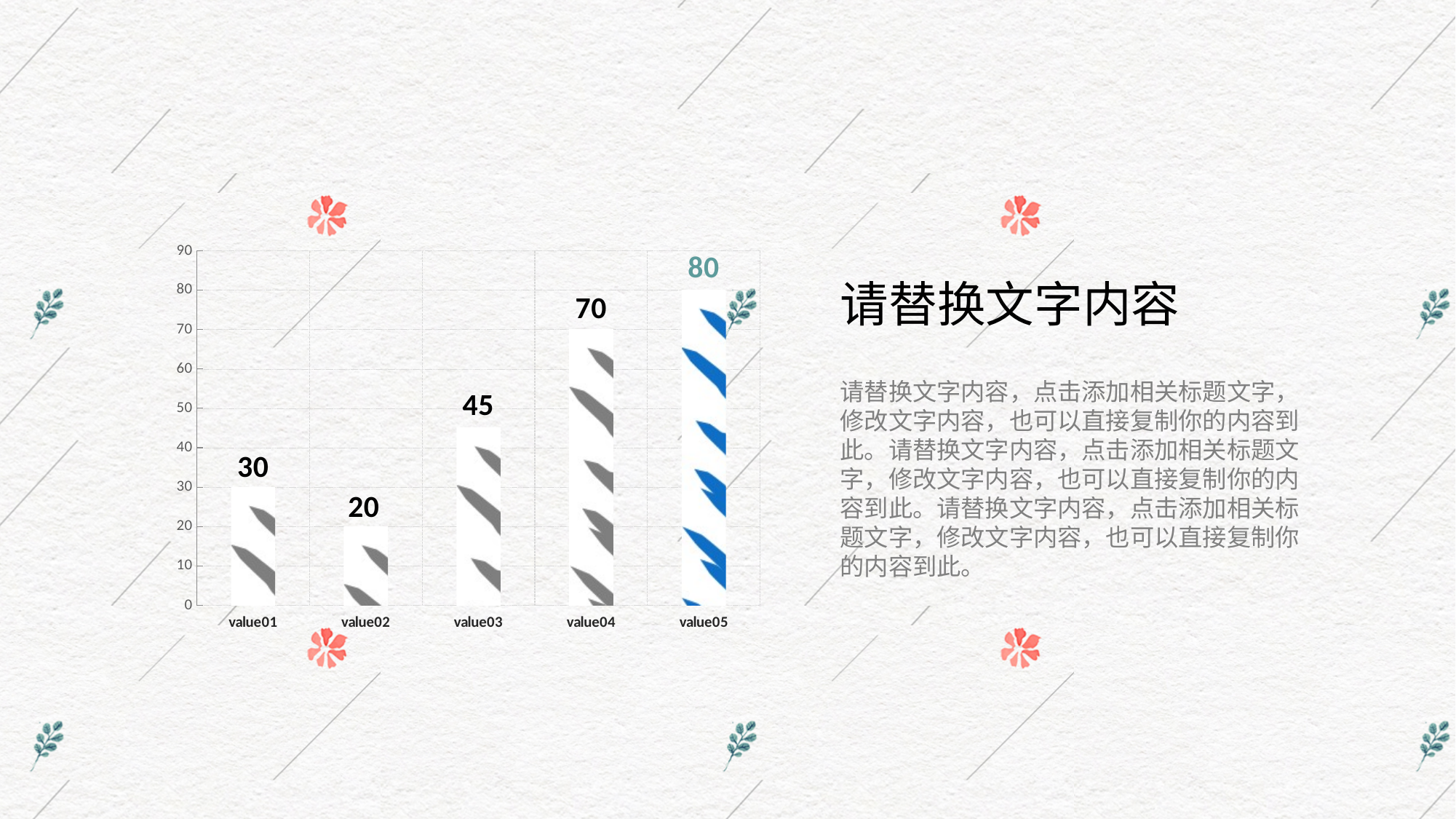
What is the highest tick value shown on the y axis? 90 Which bar is drawn in blue rather than grey? value05 How many categories are shown on the x axis? 5 What is the value for value02? 20 What is the value for value05? 80 What is the difference between the values for value04 and value01? 40 Which category has the lowest value? value02 Which category has the highest value? value05 Is the value for value04 greater or less than 60? greater Which is larger, the value for value03 or the value for value02? value03 What is the value for value03? 45 What kind of chart is shown on the slide? bar chart